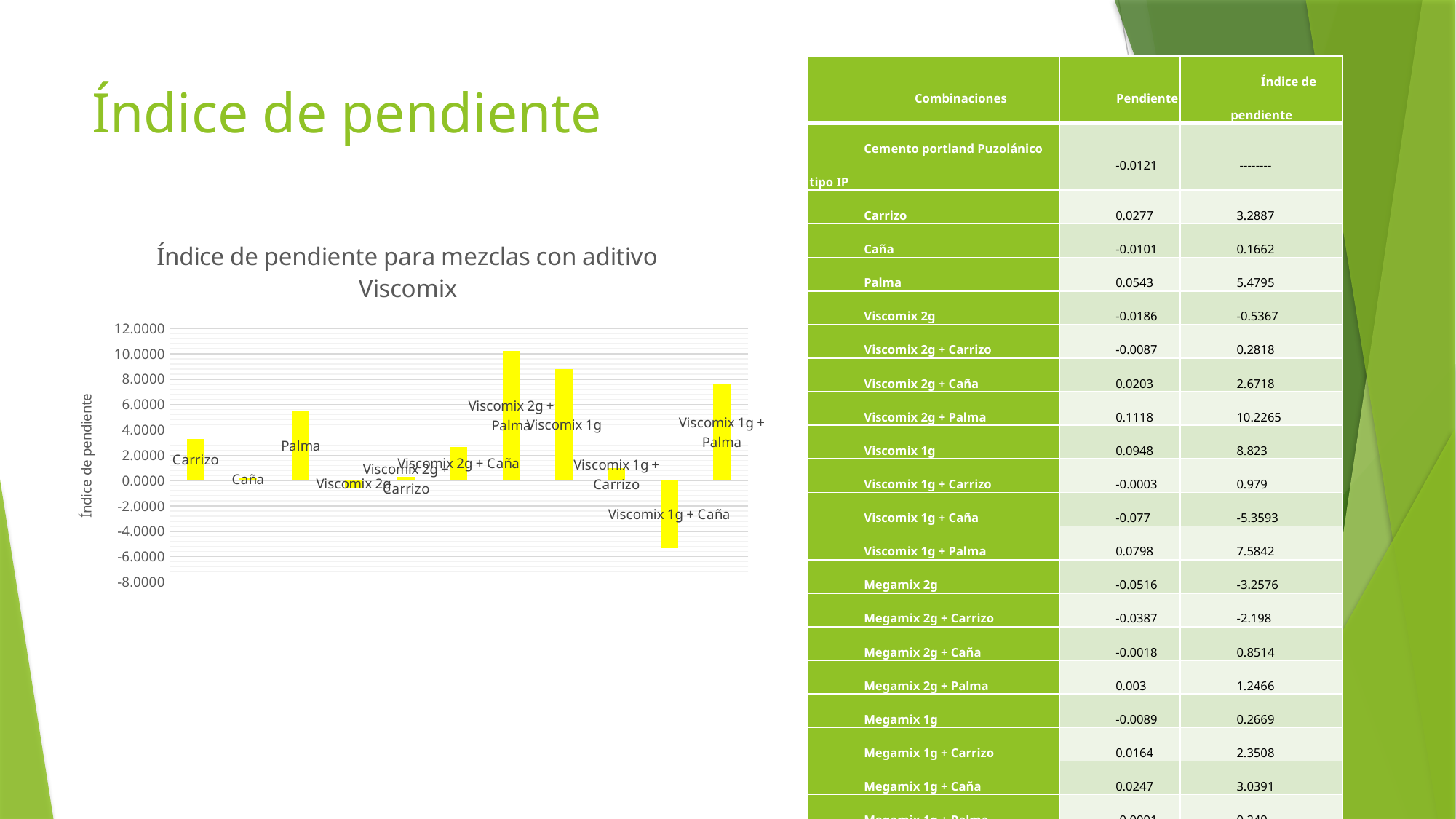
What type of chart is shown on the slide? bar chart What is the label of the vertical axis of the chart? Índice de pendiente Which category has the lowest value in the chart? Viscomix 1g + Caña Which category has the highest value in the chart? Viscomix 2g + Palma Which is larger in the chart, the value for Viscomix 1g or the value for Viscomix 1g + Palma? Viscomix 1g Is the value for Viscomix 2g + Palma greater or less than 8.0000? greater What is the title of the chart? Índice de pendiente para mezclas con aditivo Viscomix How many categories (bars) are plotted in the chart? 11 Which is larger in the chart, the value for Palma or the value for Carrizo? Palma Is the value for Palma greater or less than 4.0000? greater Is the value for Viscomix 1g + Caña greater or less than -4.0000? less How many bars in the chart have a negative value? 2